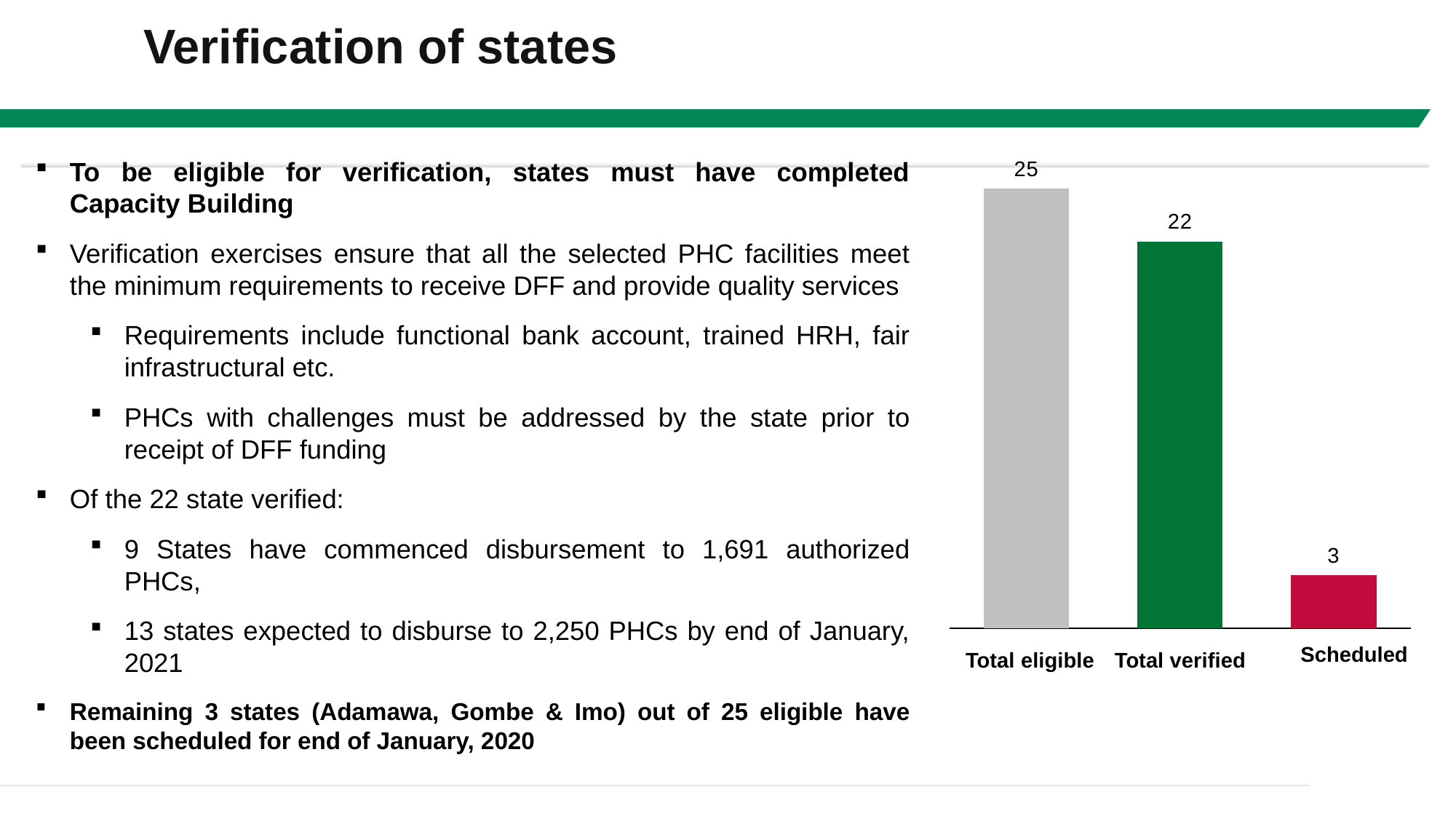
How many categories are shown in the chart? 3 Do the values rise or fall from left to right across the categories? Fall What is the value for Total eligible? 25 Which category has the highest value? Total eligible Which is larger, Total verified or Scheduled? Total verified Which category has the lowest value? Scheduled What is the value for Total verified? 22 What is the value for Scheduled? 3 What colour is the bar for Total verified? Green What is the difference between Total verified and Scheduled? 19 What is the difference between Total eligible and Total verified? 3 What kind of chart is shown on the slide? Bar chart